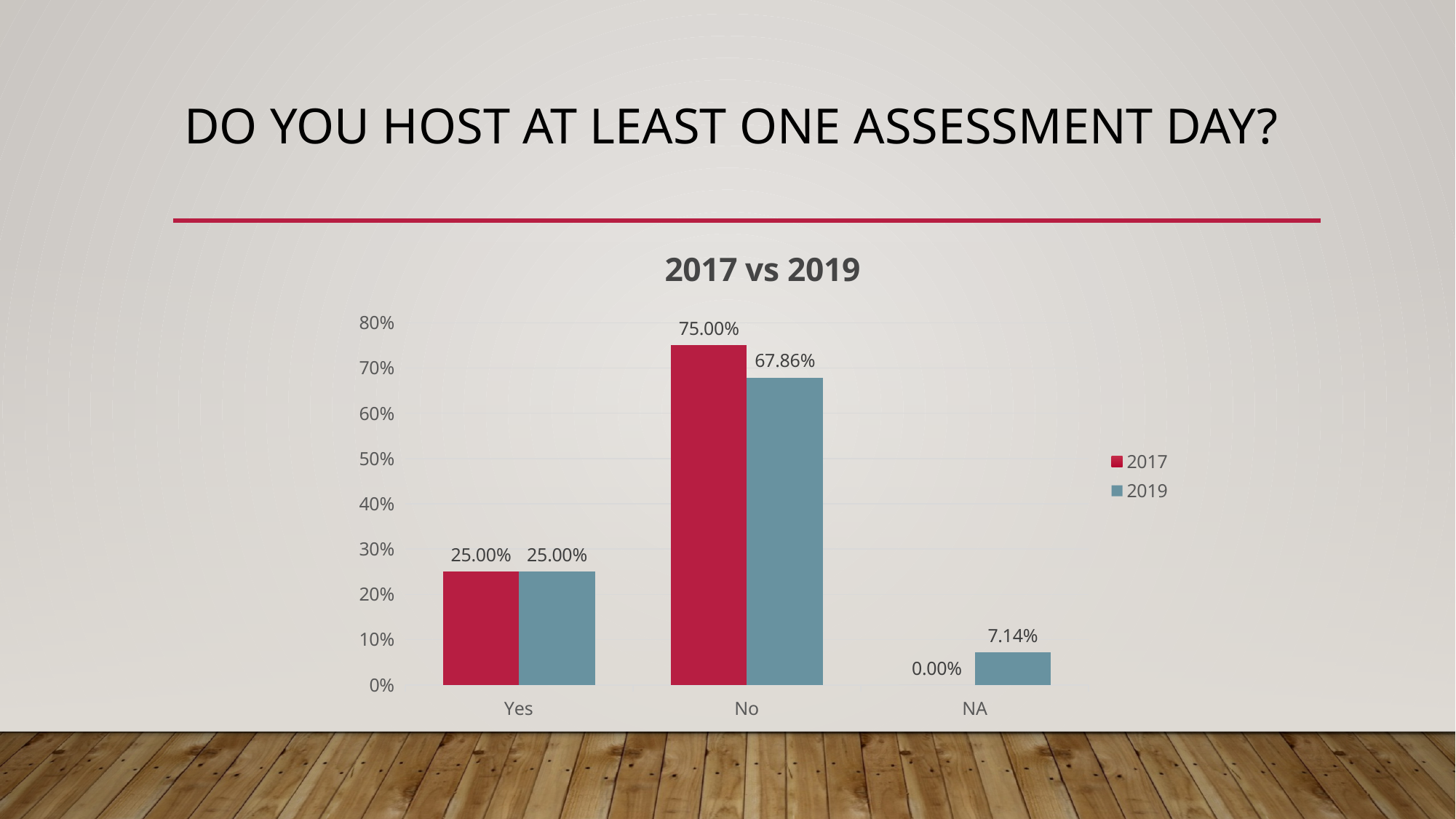
What is the title of the chart? 2017 vs 2019 How many categories are shown on the x axis? 3 What is the value for 'Yes' in the 2017 series? 25.00% What is the difference between the 2017 and 2019 values for 'No'? 7.14% How many series does the legend list? 2 What kind of chart is shown on the slide? Bar chart What is the value for 'No' in the 2019 series? 67.86% Which category has the lowest value in the 2017 series? NA What is the value for 'NA' in the 2019 series? 7.14% What is the value for 'No' in the 2017 series? 75.00% Which is larger for 'NA': the 2017 value or the 2019 value? 2019 Which category has the highest value in the 2019 series? No